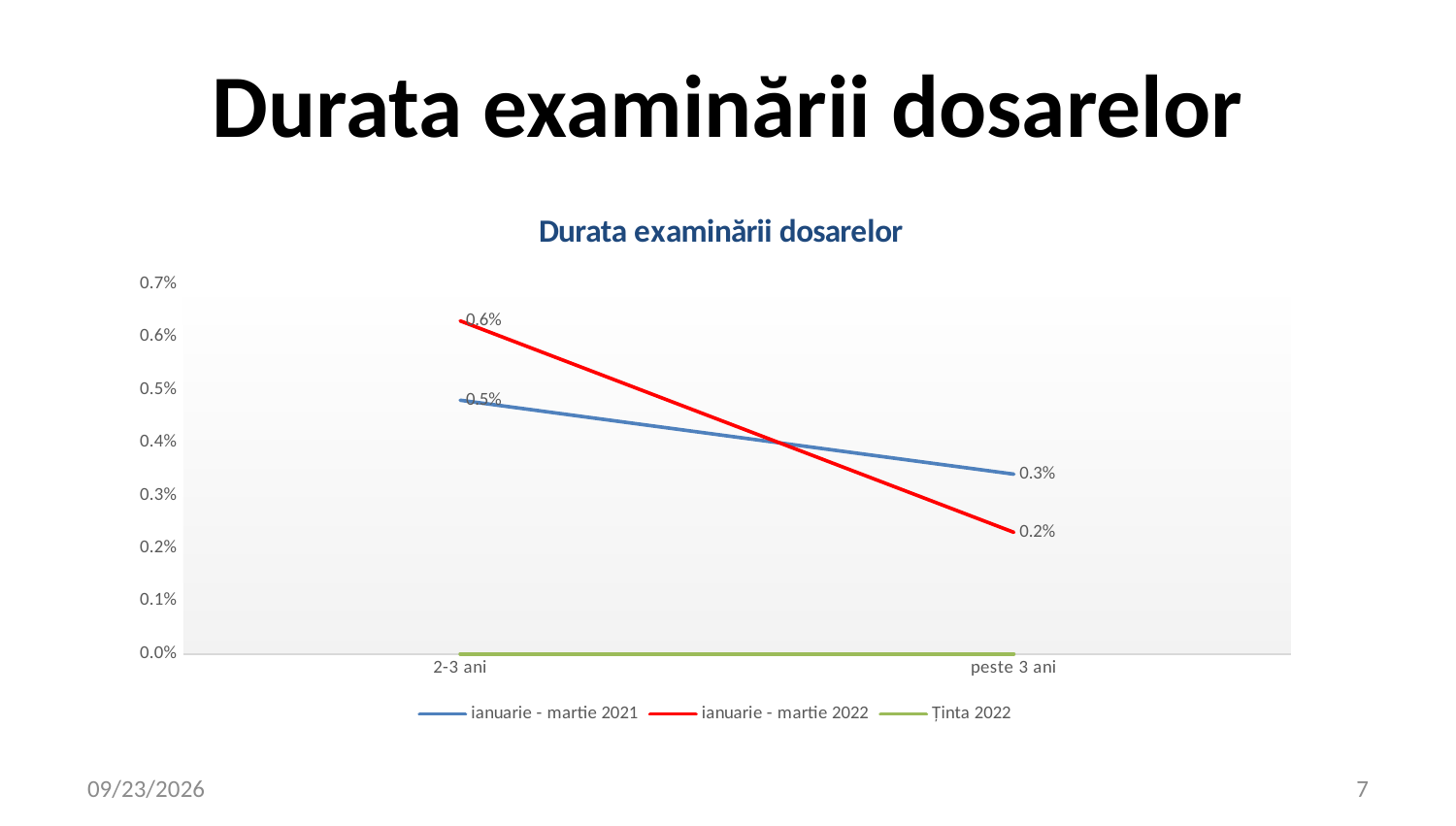
What is the value for 'ianuarie - martie 2021' at '2-3 ani'? 0.5% What is the value for 'ianuarie - martie 2022' at '2-3 ani'? 0.6% What is the value for 'ianuarie - martie 2022' at 'peste 3 ani'? 0.2% Which series has the lower value at 'peste 3 ani', 'ianuarie - martie 2021' or 'ianuarie - martie 2022'? ianuarie - martie 2022 What is the difference between the 'ianuarie - martie 2021' values at '2-3 ani' and 'peste 3 ani'? 0.2% Does the 'ianuarie - martie 2022' line rise or fall from '2-3 ani' to 'peste 3 ani'? fall Is the value for 'ianuarie - martie 2022' at '2-3 ani' greater or less than 0.5%? greater What is the value for 'ianuarie - martie 2021' at 'peste 3 ani'? 0.3% Which series has the higher value at '2-3 ani', 'ianuarie - martie 2021' or 'ianuarie - martie 2022'? ianuarie - martie 2022 What is the difference between the 'ianuarie - martie 2022' values at '2-3 ani' and 'peste 3 ani'? 0.4% How many series does the legend list? 3 What kind of chart is shown on the slide? line chart